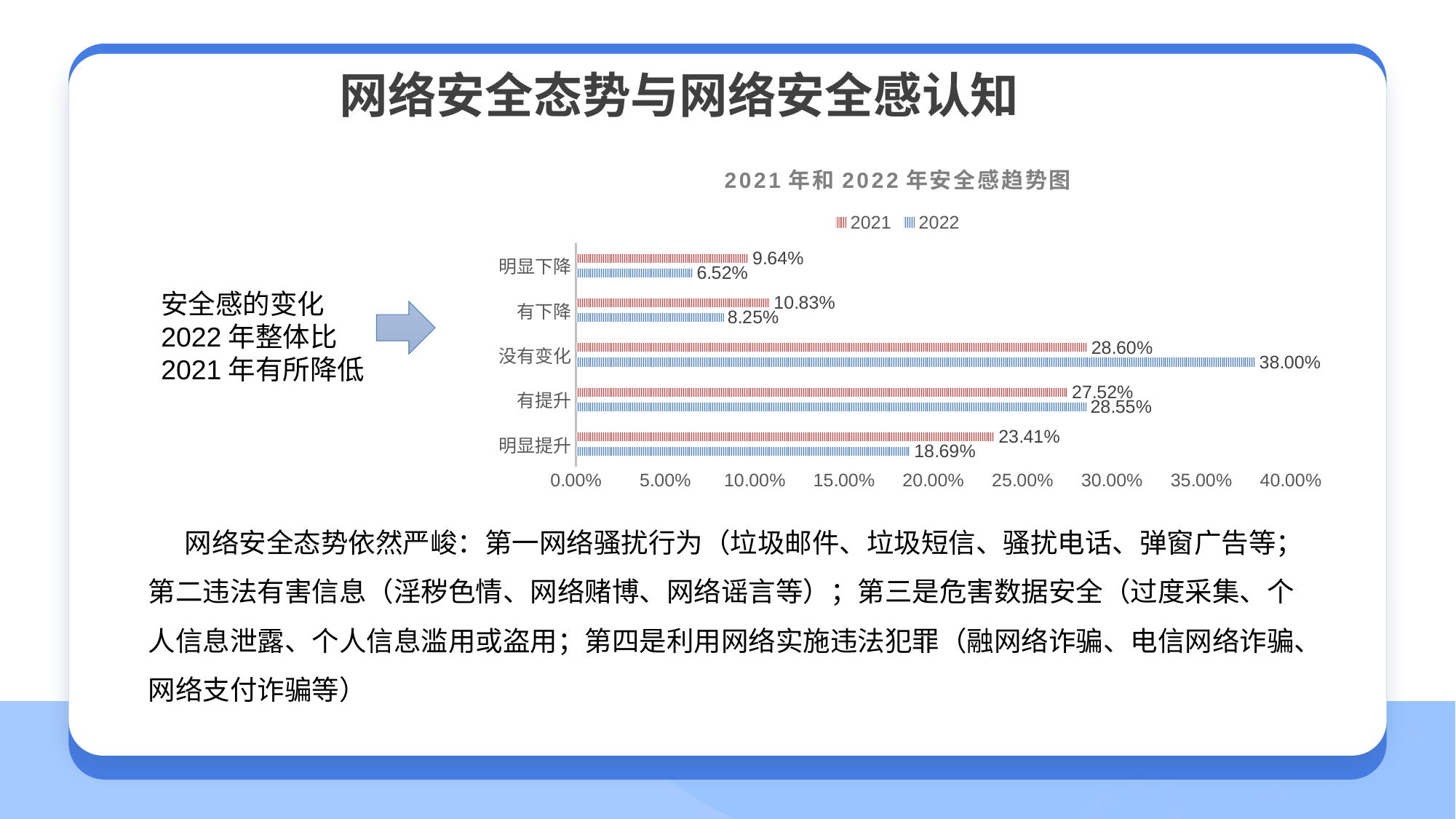
What is the title of the chart? 2021 年和 2022 年安全感趋势图 What is the 2022 value for 没有变化? 38.00% Which category has the highest 2022 value? 没有变化 What is the 2021 value for 有下降? 10.83% Which category has the lowest 2021 value? 明显下降 What is the difference between the 2022 and 2021 values for 没有变化? 9.40% Which is larger for 明显提升: the 2021 value or the 2022 value? 2021 How many series does the legend list? 2 How many categories are shown on the chart? 5 What kind of chart is shown on the slide? Bar chart What is the 2022 value for 明显下降? 6.52% What is the 2021 value for 明显提升? 23.41%